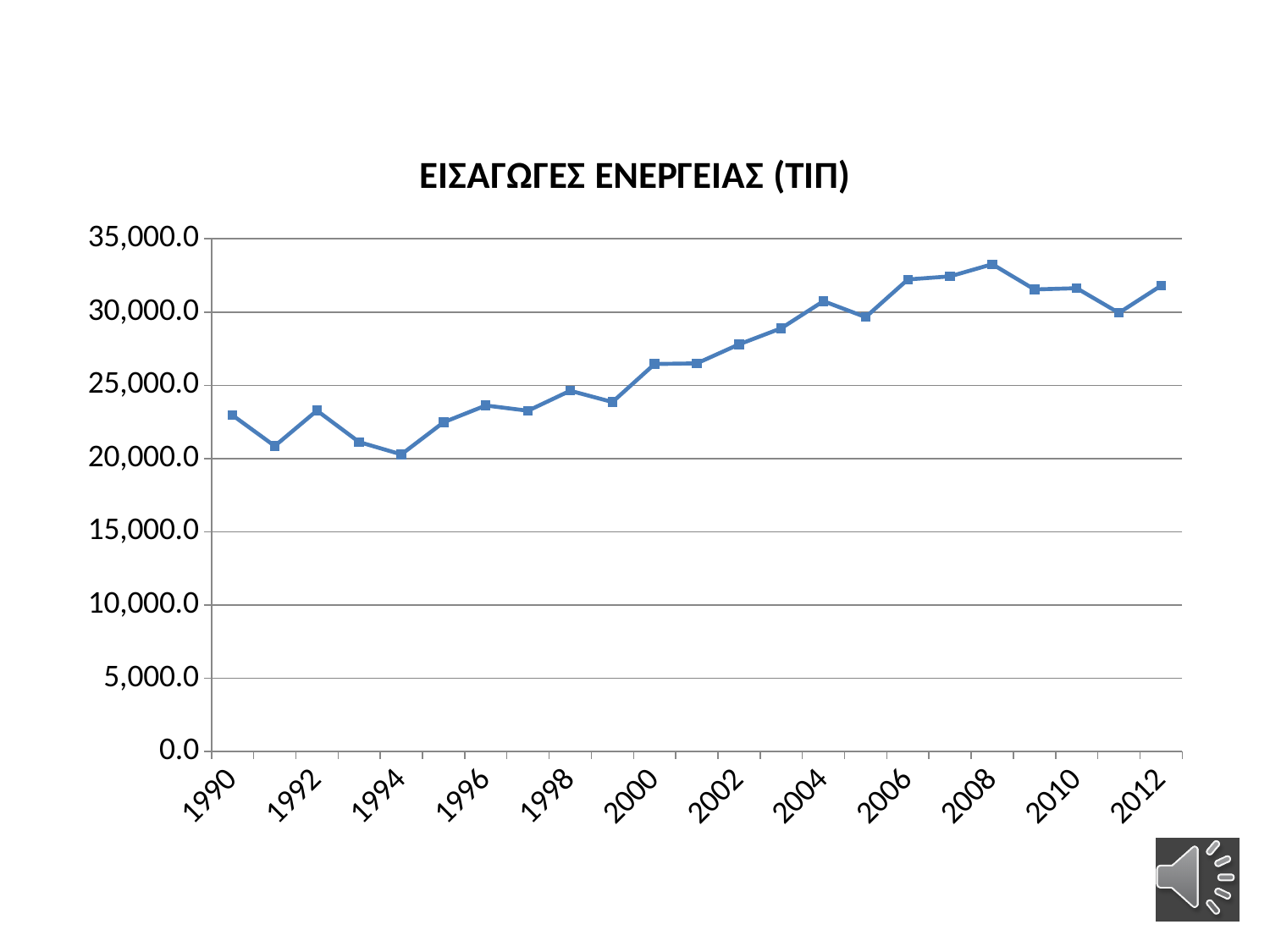
How many data points are plotted on the line? 23 In which year does the line reach its highest value? 2008 Is the value for 2006 greater or less than 30,000.0? greater Is the value for 2012 greater or less than 30,000.0? greater Is the value for 1990 greater or less than 20,000.0? greater Which year has the larger value, 1992 or 1994? 1992 What kind of chart is shown on the slide? Line chart In which year does the line reach its lowest value? 1994 What is the title of the chart? ΕΙΣΑΓΩΓΕΣ ΕΝΕΡΓΕΙΑΣ (ΤΙΠ) Overall, do the values rise or fall from 1990 to 2012? Rise